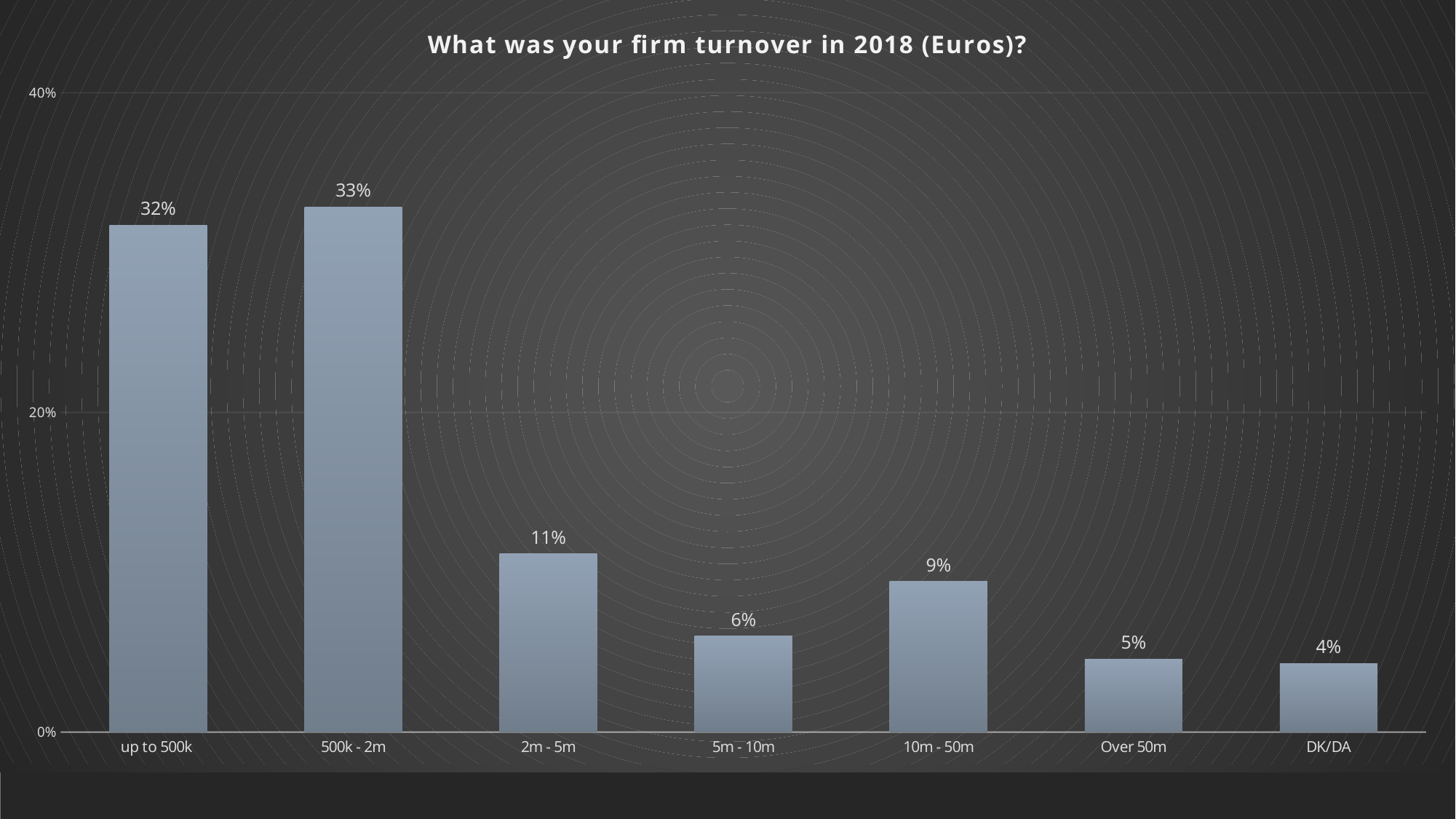
What is the difference between the 500k - 2m and the 2m - 5m categories? 22% Which turnover category has the lowest percentage? DK/DA What percentage of firms answered DK/DA? 4% Which turnover category has the highest percentage? 500k - 2m How many turnover categories are shown on the chart? 7 Which is larger, the value for 10m - 50m or the value for 5m - 10m? 10m - 50m What kind of chart is shown on the slide? bar chart Is the value for Over 50m greater or less than 20%? less What is the combined percentage for the 5m - 10m and 10m - 50m categories? 15% What is the value for the 2m - 5m turnover category? 11% What is the title of the chart? What was your firm turnover in 2018 (Euros)? What percentage of firms reported a turnover of up to 500k? 32%